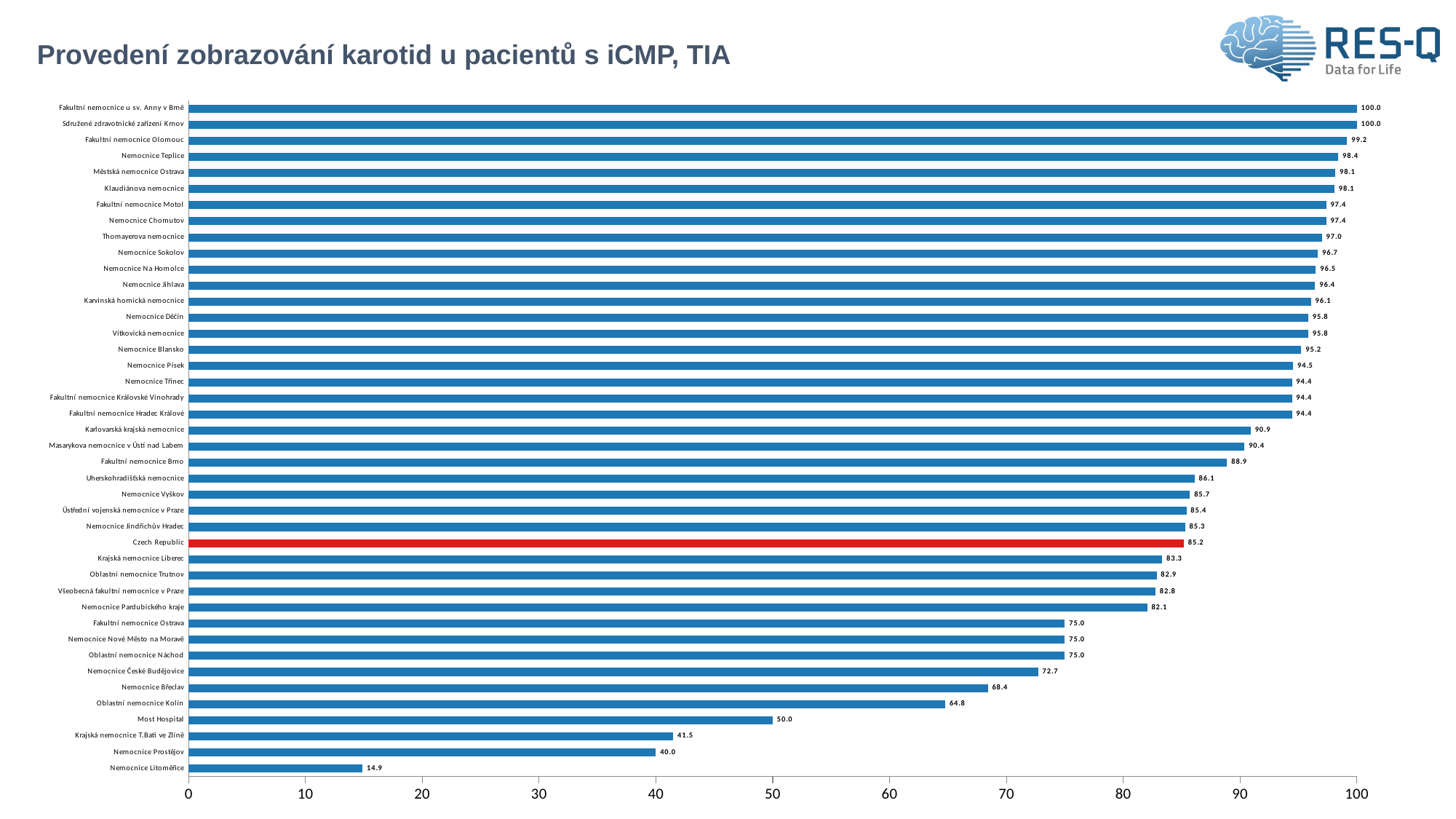
Which is larger, the value for Oblastní nemocnice Kolín or the value for Nemocnice České Budějovice? Nemocnice České Budějovice What kind of chart is shown on the slide? bar chart Which category has the lowest value? Nemocnice Litoměřice How many categories are shown on the chart? 42 What is the difference between the values for Czech Republic and Nemocnice Prostějov? 45.2 What is the value for Most Hospital? 50.0 What is the value for Nemocnice Litoměřice? 14.9 What is the value for Czech Republic? 85.2 Which bar is highlighted in red? Czech Republic What is the difference between the values for Fakultní nemocnice Olomouc and Nemocnice Břeclav? 30.8 What is the value for Fakultní nemocnice Brno? 88.9 Is the value for Krajská nemocnice T.Bati ve Zlíně greater or less than 50? less